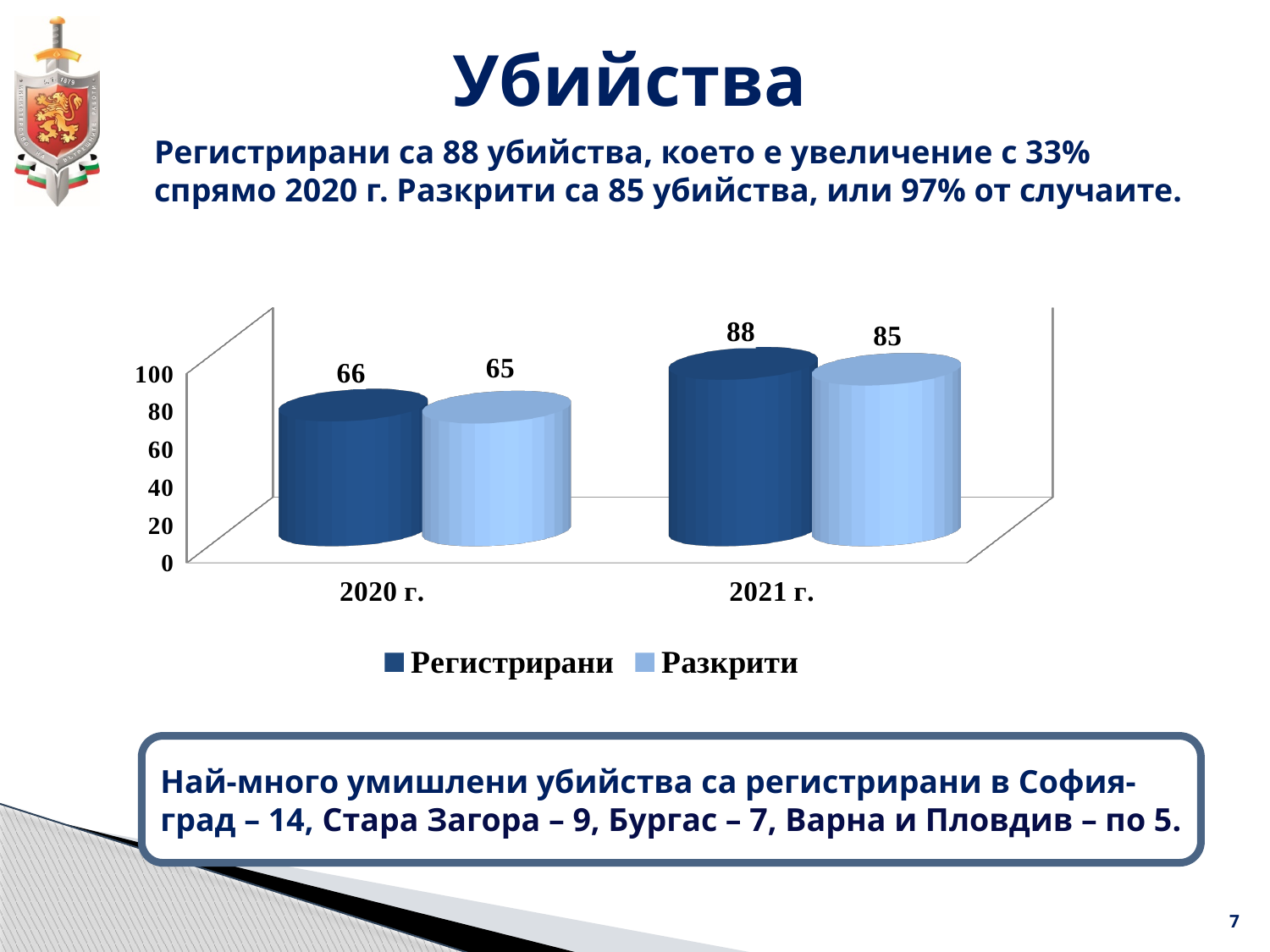
How many series does the legend list? 2 Which year has the highest value for Регистрирани? 2021 г. What kind of chart is shown on the slide? bar chart What is the value for Регистрирани in 2020 г.? 66 How many categories are shown on the x axis? 2 What is the difference between Регистрирани in 2021 г. and Регистрирани in 2020 г.? 22 What is the value for Разкрити in 2021 г.? 85 What is the value for Разкрити in 2020 г.? 65 What is the difference between Регистрирани and Разкрити in 2021 г.? 3 Which year has the lowest value for Разкрити? 2020 г. Which is larger: Разкрити in 2021 г. or Регистрирани in 2020 г.? Разкрити in 2021 г. Do the values for Регистрирани rise or fall from 2020 г. to 2021 г.? rise